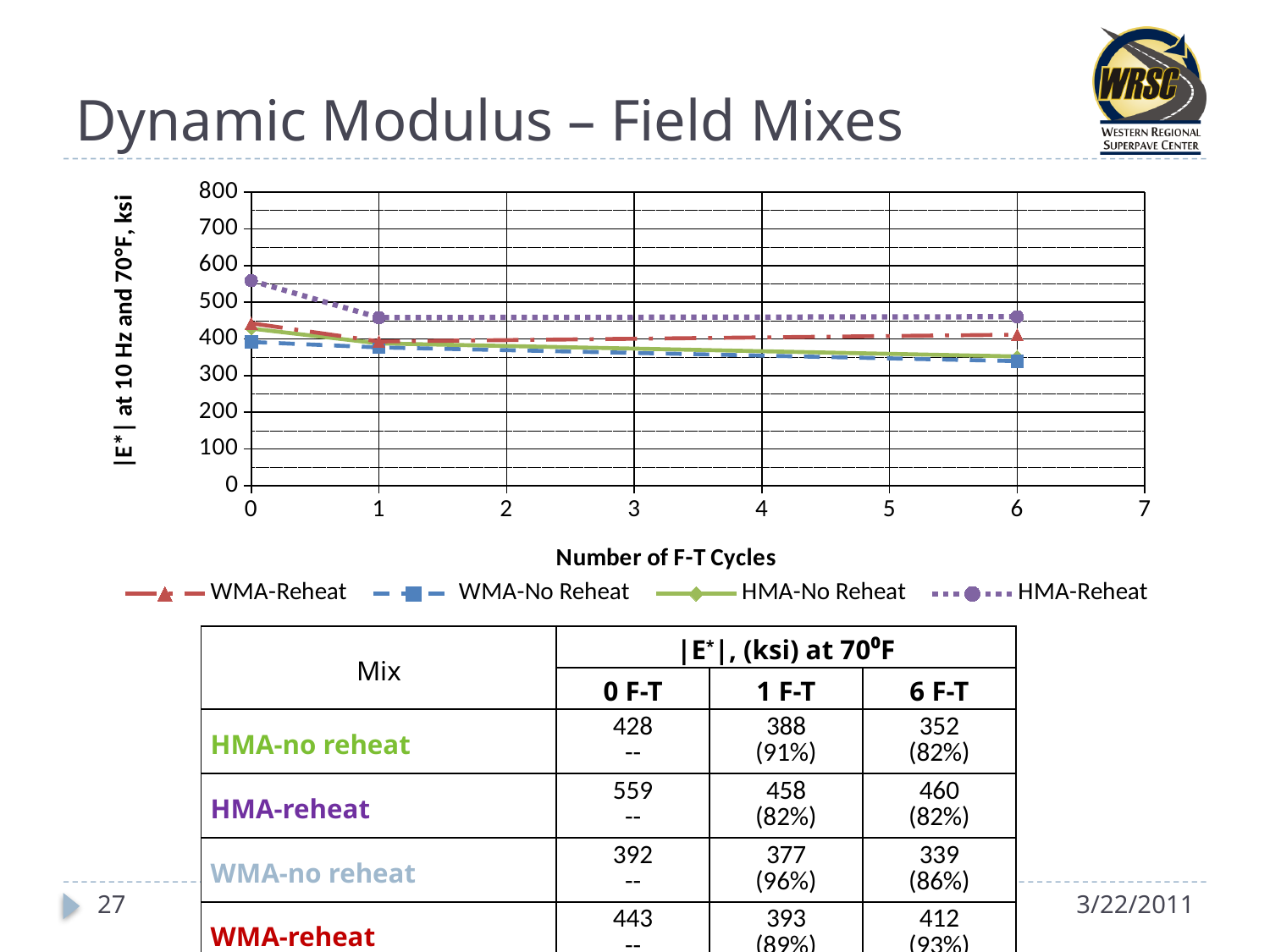
Which series has the highest value at 6 F-T cycles? HMA-Reheat What is the title of the x axis of the chart? Number of F-T Cycles Does the WMA-No Reheat series rise or fall as the number of F-T cycles increases? fall What type of chart is shown on the slide? line chart How many data points are plotted for each series in the chart? 3 Is the value for WMA-No Reheat at 6 F-T cycles greater or less than 400? less At 6 F-T cycles, which is larger: WMA-Reheat or HMA-No Reheat? WMA-Reheat Which series has the highest value at 0 F-T cycles? HMA-Reheat According to the table on the slide, what is the |E*| value for HMA-reheat at 0 F-T? 559 Using the values in the table, what is the difference between HMA-reheat and WMA-reheat at 0 F-T? 116 How many series does the chart legend list? 4 Is the value for HMA-Reheat at 0 F-T cycles greater or less than 500? greater